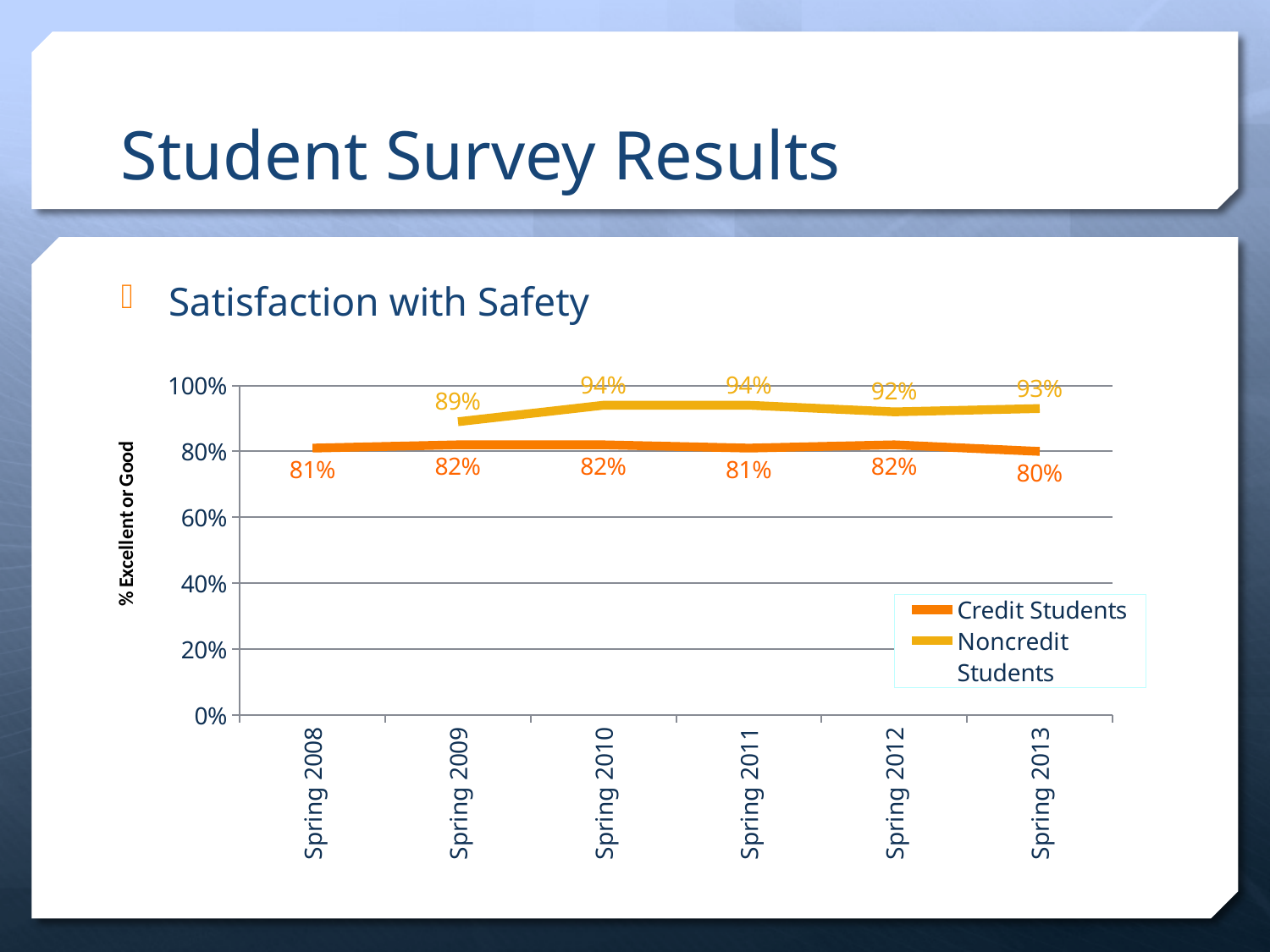
What is the difference between Noncredit Students and Credit Students in Spring 2010? 12% Does the Noncredit Students line rise or fall from Spring 2009 to Spring 2010? Rise How many time points are plotted on the x axis? 6 In which year is the Credit Students value lowest? Spring 2013 What is the value for Credit Students in Spring 2008? 81% Which series has the higher value in Spring 2011, Credit Students or Noncredit Students? Noncredit Students What is the value for Noncredit Students in Spring 2009? 89% What kind of chart is shown? Line chart What is the value for Credit Students in Spring 2013? 80% How many series does the legend list? 2 What is the value for Noncredit Students in Spring 2012? 92% What is the label on the vertical axis? % Excellent or Good